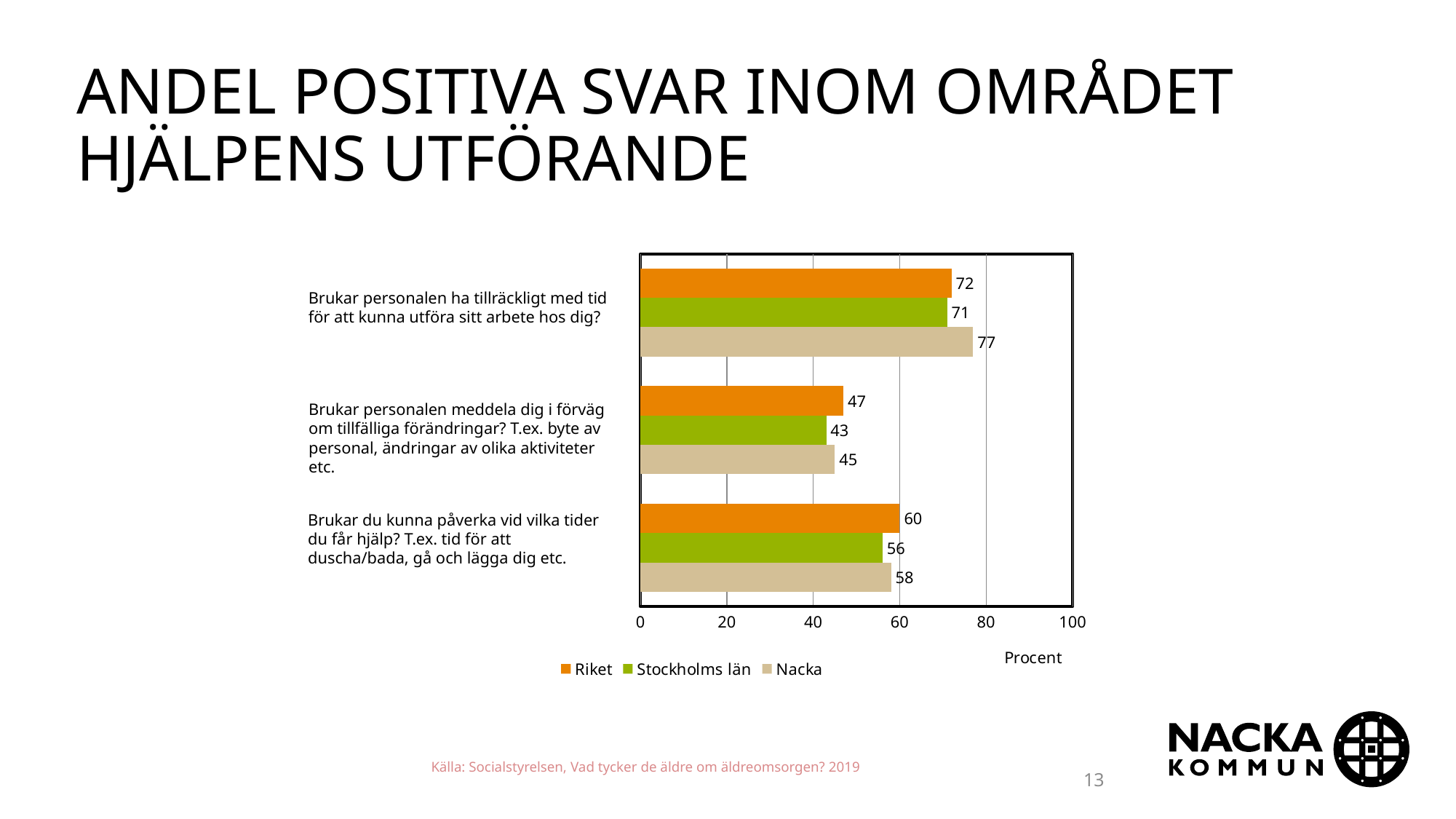
Which series has the lowest value on the question "Brukar personalen meddela dig i förväg om tillfälliga förändringar?"? Stockholms län Is the value for Nacka on the question "Brukar du kunna påverka vid vilka tider du får hjälp?" greater or less than 60? less What is the value for Stockholms län on the question "Brukar du kunna påverka vid vilka tider du får hjälp?"? 56 Which is larger on the question "Brukar personalen meddela dig i förväg om tillfälliga förändringar?": Riket or Nacka? Riket Which series has the highest value on the question "Brukar personalen ha tillräckligt med tid för att kunna utföra sitt arbete hos dig?"? Nacka How many series does the legend list? 3 What unit is labelled on the x axis of the chart? Procent What kind of chart is shown on the slide? Bar chart What is the value for Nacka on the question "Brukar personalen ha tillräckligt med tid för att kunna utföra sitt arbete hos dig?"? 77 How many questions (categories) are shown in the chart? 3 What is the value for Riket on the question "Brukar personalen meddela dig i förväg om tillfälliga förändringar?"? 47 What is the difference between the Riket and Stockholms län values on the question "Brukar du kunna påverka vid vilka tider du får hjälp?"? 4